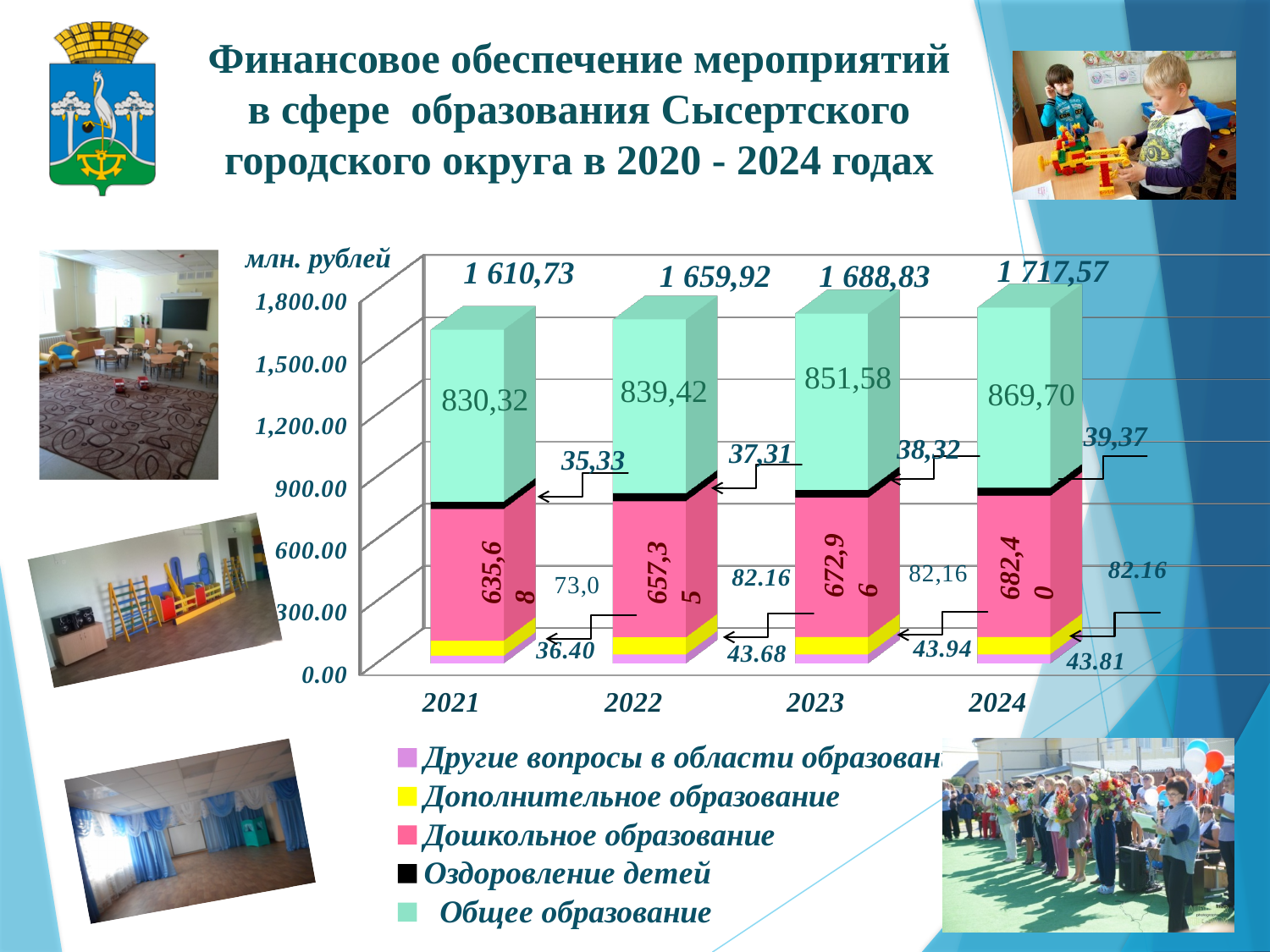
Which year has the highest total value? 2024 What is the value for Оздоровление детей in 2022? 37,31 What is the value for Другие вопросы в области образования in 2021? 36.40 What is the total value shown above the bar for 2021? 1 610,73 What kind of chart is shown on the slide? stacked bar chart What is the total value shown above the bar for 2024? 1 717,57 How many years (categories) are plotted on the x axis of the chart? 4 Do the total values rise or fall from 2021 to 2024? rise How many series does the chart legend list? 5 What is the value for Общее образование in 2023? 851,58 Which year has the lowest value for Общее образование? 2021 What is the unit of measurement shown on the chart's axis label? млн. рублей